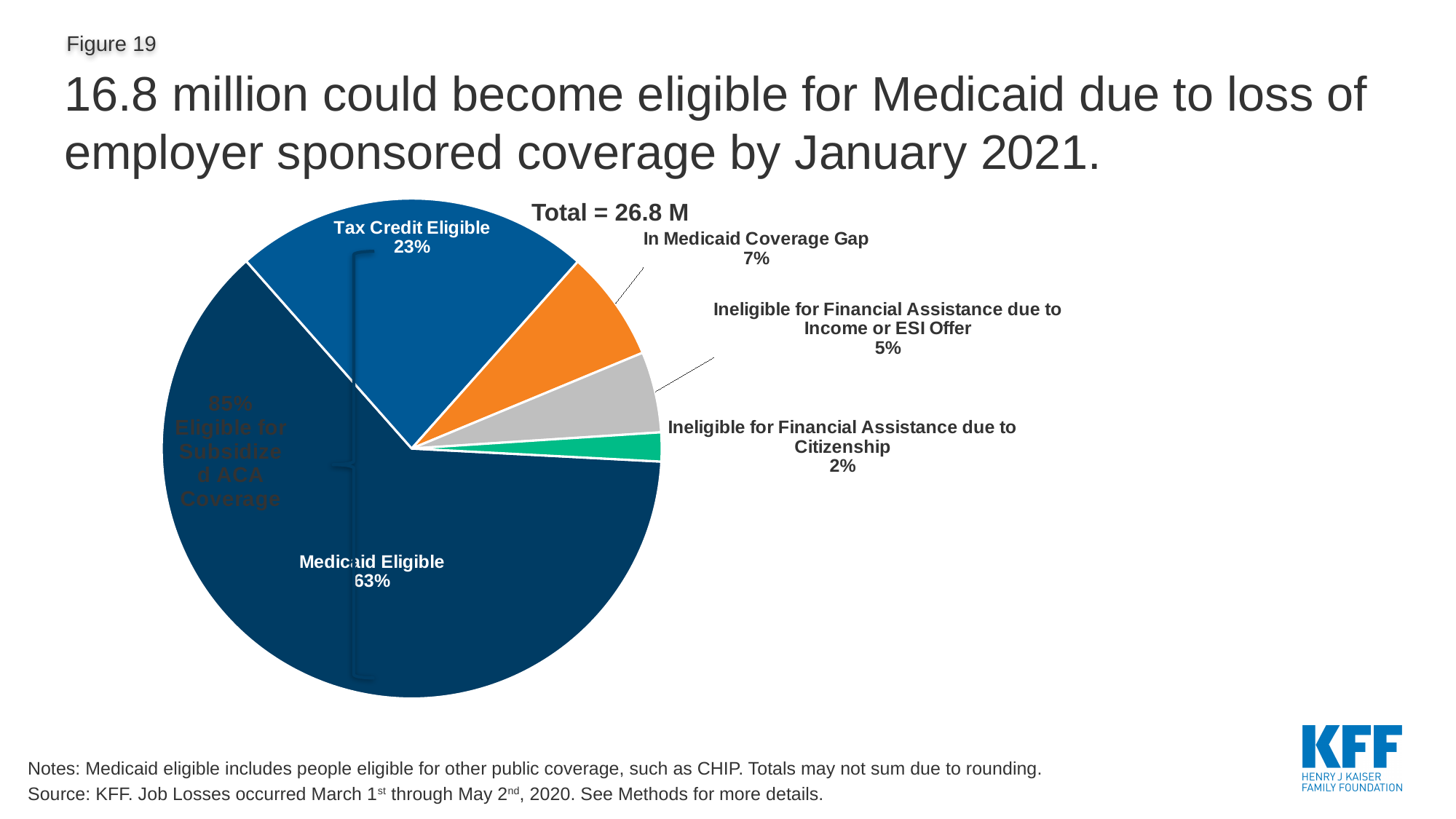
Which slice of the pie is the largest? Medicaid Eligible What kind of chart is shown on the slide? Pie chart Which slice of the pie is the smallest? Ineligible for Financial Assistance due to Citizenship What percentage is shown for In Medicaid Coverage Gap? 7% Which is larger, In Medicaid Coverage Gap or Ineligible for Financial Assistance due to Income or ESI Offer? In Medicaid Coverage Gap What percentage is shown for Ineligible for Financial Assistance due to Citizenship? 2% What total is stated above the pie chart? Total = 26.8 M What is the difference in percentage points between Medicaid Eligible and Tax Credit Eligible? 40 percentage points What share of the pie is Tax Credit Eligible? 23% What share of the pie is Medicaid Eligible? 63% What percentage is shown for Ineligible for Financial Assistance due to Income or ESI Offer? 5% How many slices does the pie chart have? 5